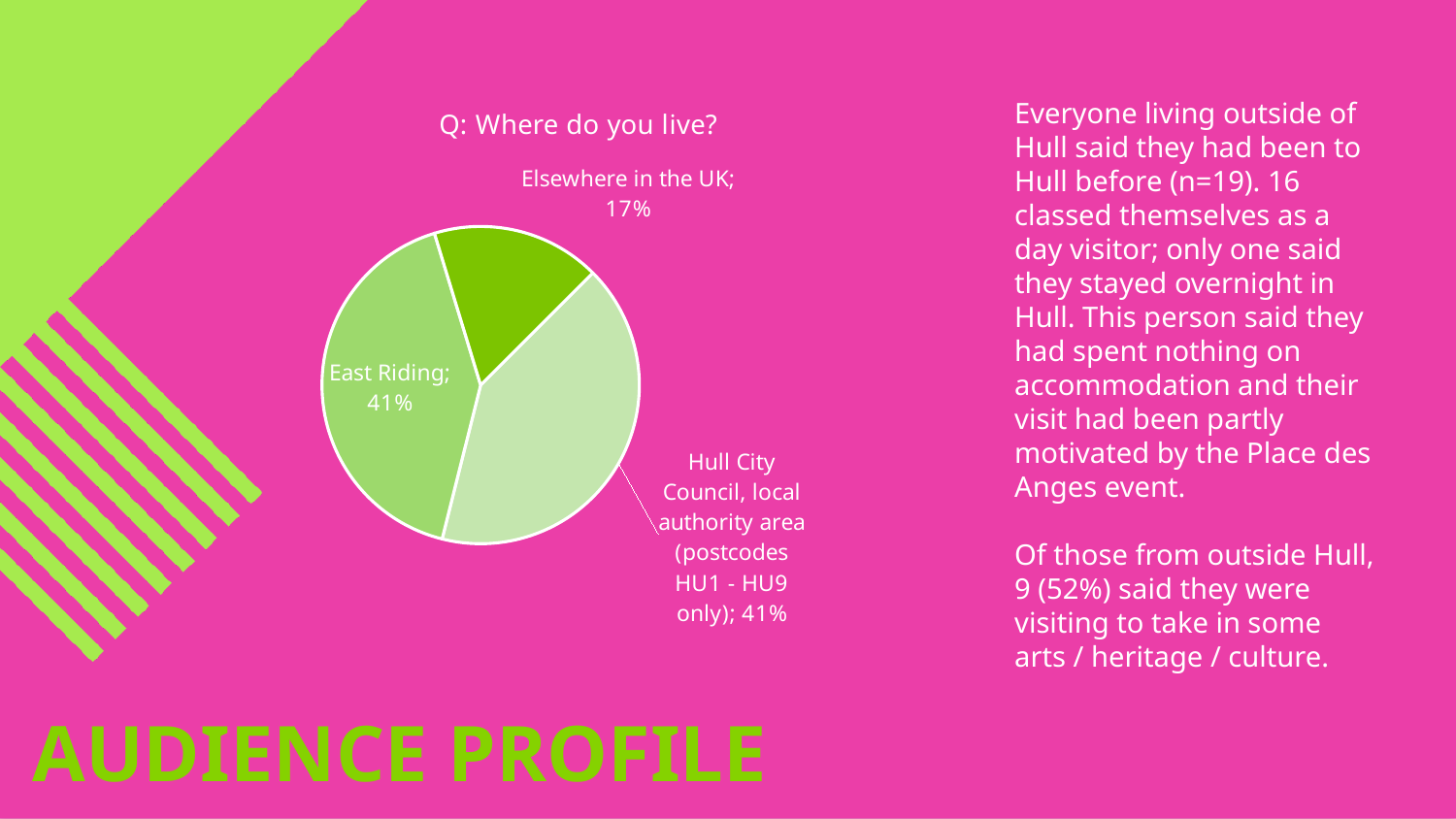
Which is larger: the share for East Riding or the share for Elsewhere in the UK? East Riding What kind of chart is shown on the slide? Pie chart What percentage of respondents live in East Riding? 41% What percentage of respondents live in the Hull City Council local authority area (postcodes HU1 - HU9 only)? 41% How many slices does the pie chart have? 3 What is the difference in percentage points between the Hull City Council local authority area share and the Elsewhere in the UK share? 24 percentage points What percentage of respondents live elsewhere in the UK? 17% Which two categories have the same share of the pie? East Riding and Hull City Council, local authority area Which category has the smallest share of the pie? Elsewhere in the UK What share of the pie does the Elsewhere in the UK slice represent? 17% What is the difference in percentage points between the East Riding share and the Elsewhere in the UK share? 24 percentage points What is the title of the chart? Q: Where do you live?